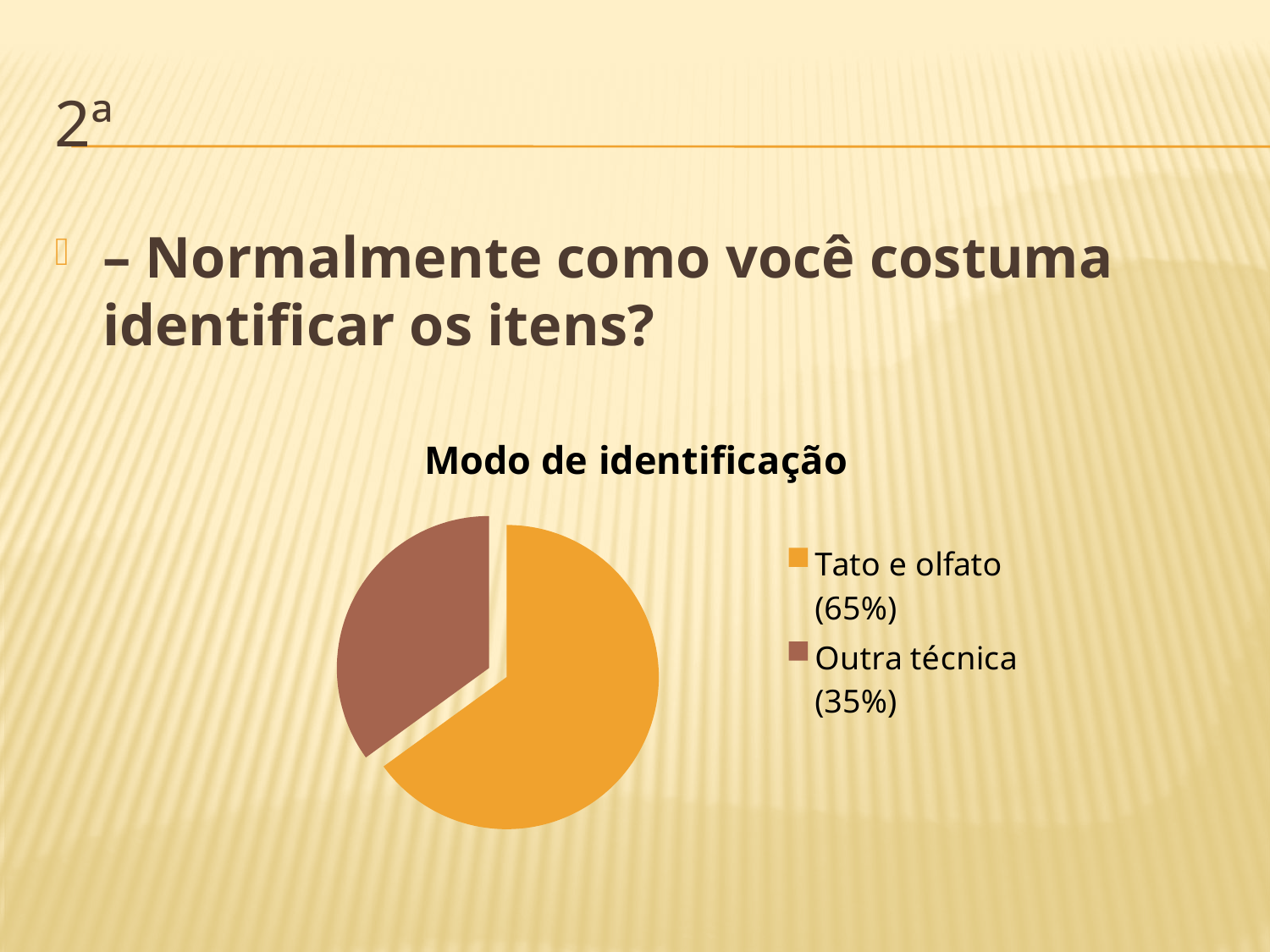
What share of the pie does "Outra técnica" represent? 35% Which category has the smallest slice of the pie? Outra técnica How many entries does the legend list? 2 What is the title of the chart? Modo de identificação What colour is the slice for "Outra técnica"? brown What share of the pie does "Tato e olfato" represent? 65% What kind of chart is shown on the slide? pie chart What is the difference in percentage points between "Tato e olfato" and "Outra técnica"? 30 Which is larger, the slice for "Tato e olfato" or the slice for "Outra técnica"? Tato e olfato How many slices does the pie chart have? 2 Which category has the largest slice of the pie? Tato e olfato